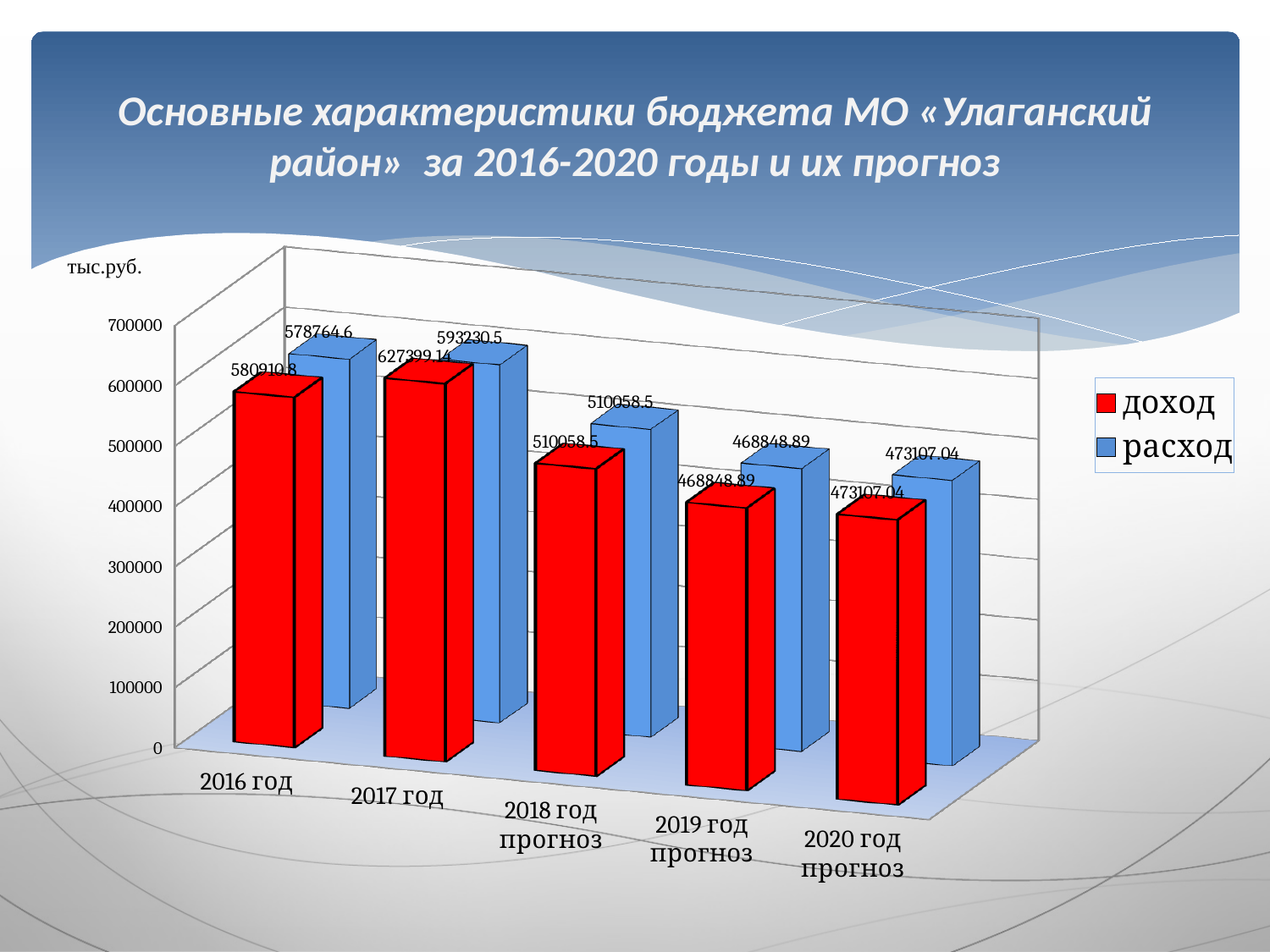
What is the value of доход for 2017 год? 627399.14 Is the value of доход for 2018 год прогноз greater or less than 600000? less What kind of chart is shown on the slide? bar chart Which is larger for 2017 год, доход or расход? доход What is the difference between доход and расход for 2016 год? 2146.2 How many series does the legend list? 2 How many year categories are shown on the x axis? 5 What is the value of расход for 2016 год? 578764.6 In which year is расход the lowest? 2019 год прогноз What is the difference between доход and расход for 2017 год? 34168.64 What is the value of расход for 2020 год прогноз? 473107.04 In which year is доход the highest? 2017 год